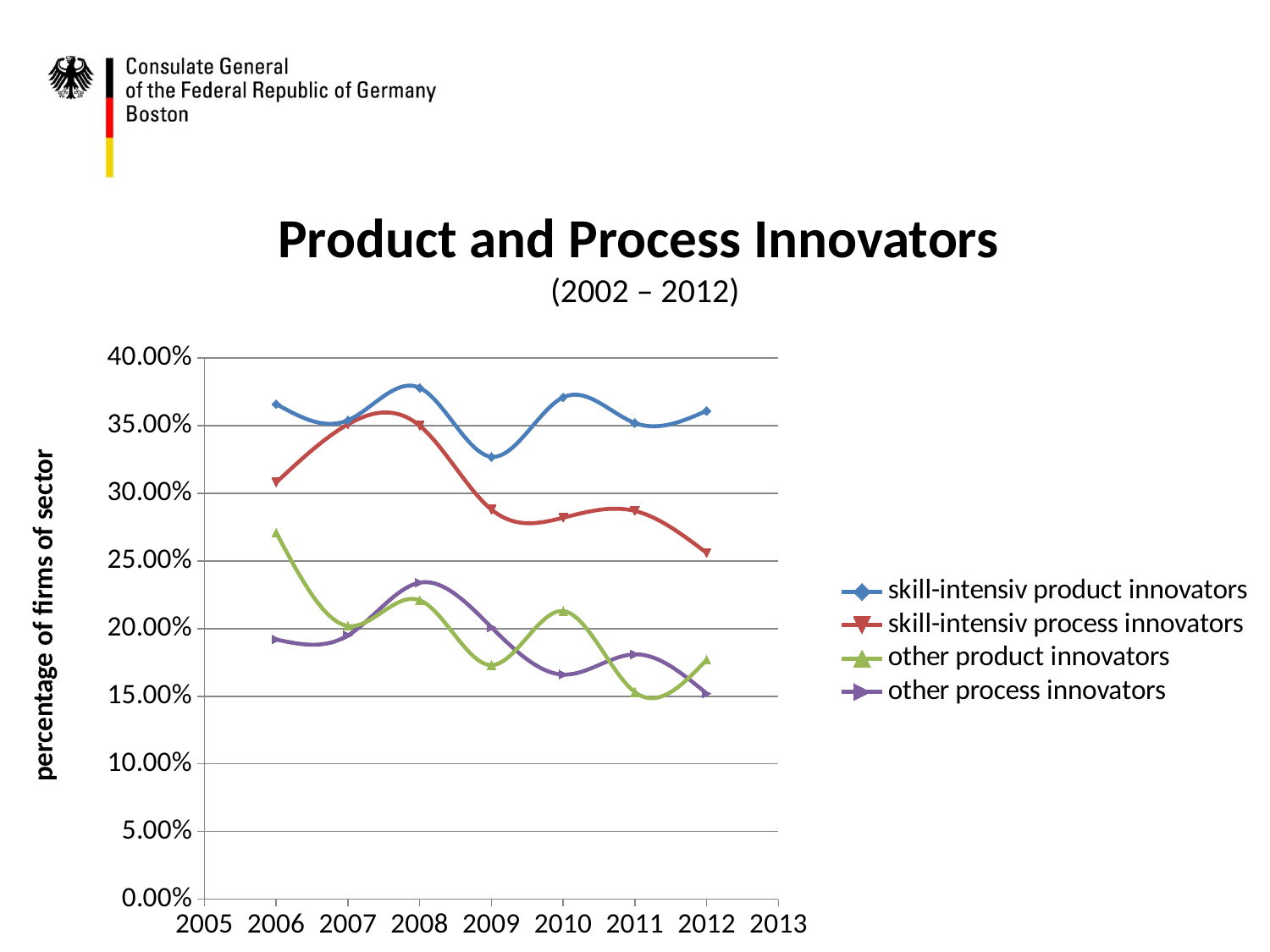
What kind of chart is shown on the slide? line chart Do the values for skill-intensiv process innovators rise or fall from 2008 to 2012? fall How many years have data points plotted for each series? 7 In 2006, which is larger: skill-intensiv product innovators or skill-intensiv process innovators? skill-intensiv product innovators Is the value for skill-intensiv product innovators in 2009 greater or less than 30.00%? greater How many series does the legend list? 4 Is the value for skill-intensiv process innovators in 2012 greater or less than 30.00%? less Is the value for other process innovators in 2010 greater or less than 20.00%? less In 2010, which is larger: other product innovators or other process innovators? other product innovators Which series has the highest value in 2012? skill-intensiv product innovators What is the label on the vertical axis of the chart? percentage of firms of sector In which year is the value for skill-intensiv product innovators lowest? 2009